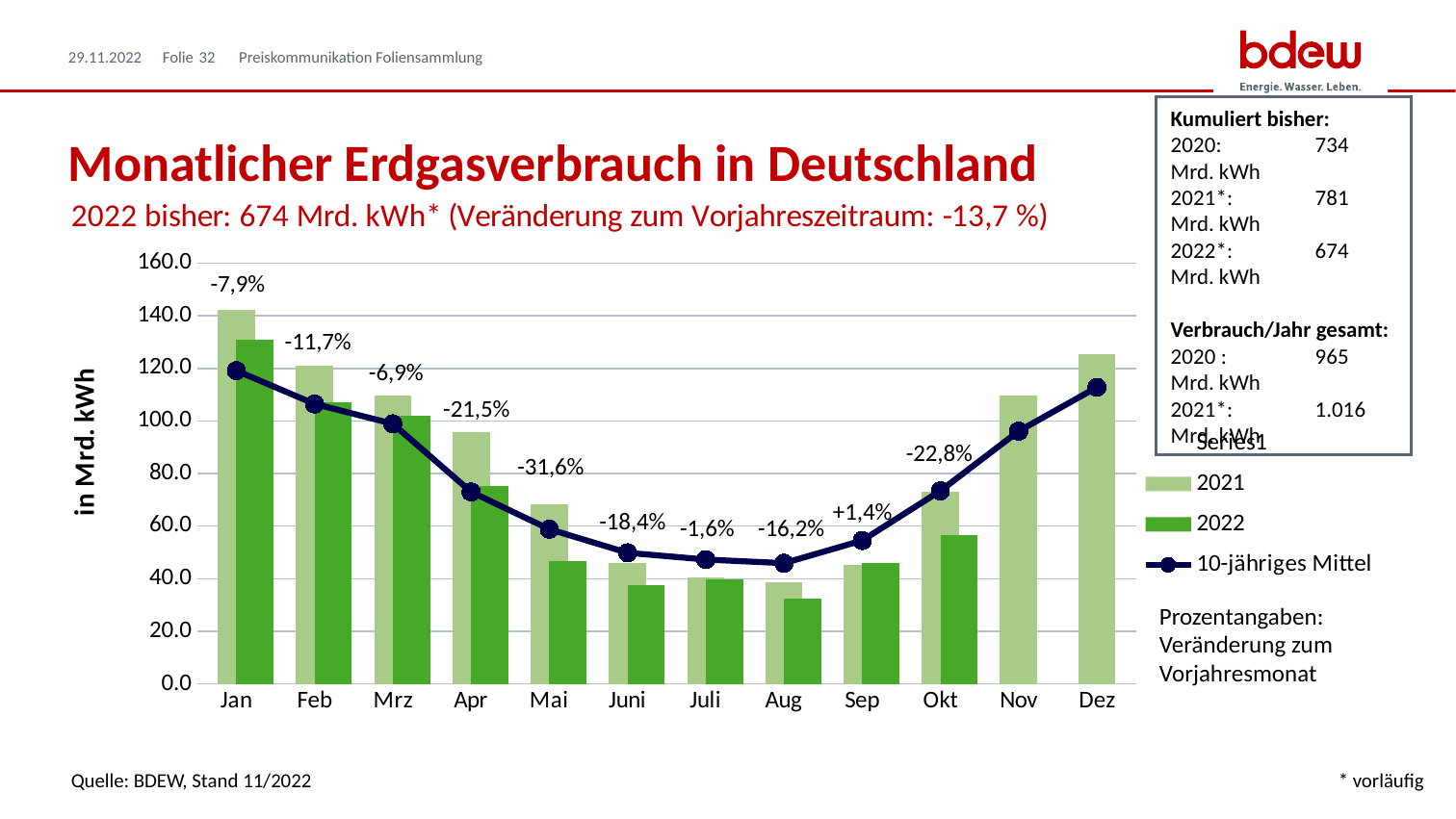
For Okt, which bar is taller, 2021 or 2022? 2021 What percentage change is shown above the bars for Mai? -31,6% What percentage change is shown for Okt? -22,8% Which month shows the largest percentage decline label? Mai Is the 2021 bar for Nov greater or less than 100? greater What percentage change is shown for Jan? -7,9% Is the 2022 bar for Aug greater or less than 40? less What is the difference between the percentage labels for Apr (-21,5%) and Mrz (-6,9%)? 14,6 percentage points Is the 2022 bar for Jan greater or less than 120? greater What kind of chart is this? bar chart with a line How many months are shown on the x axis? 12 Which month shows the only positive percentage change label? Sep